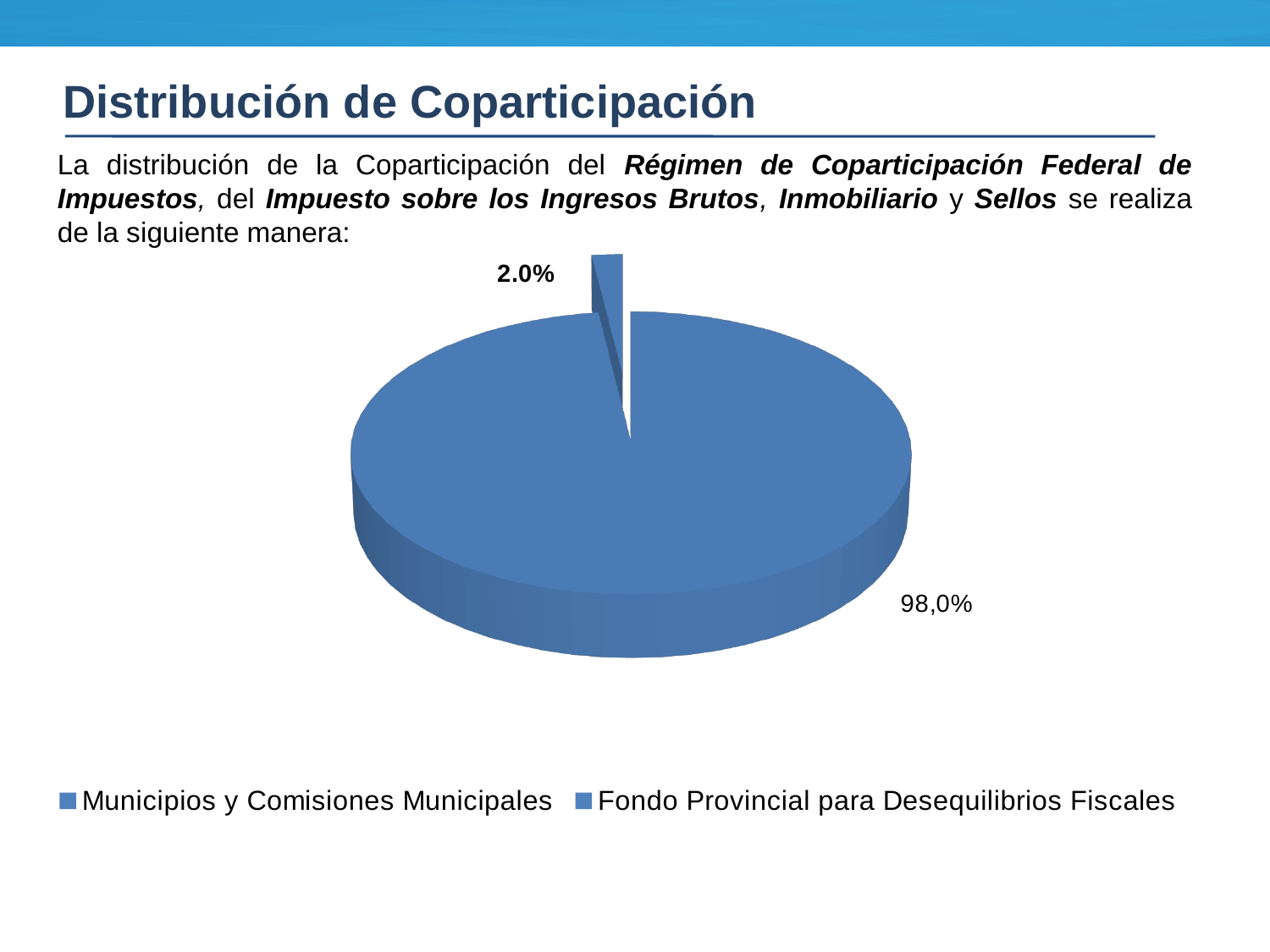
How many entries does the legend of the pie chart list? 2 What percentage is shown on the smallest slice of the pie chart? 2.0% What share of the pie does the small slice at the top represent? 2.0% What kind of chart is shown on the slide? Pie chart What is the title of the slide containing the pie chart? Distribución de Coparticipación What are the two entries listed in the legend of the pie chart? Municipios y Comisiones Municipales; Fondo Provincial para Desequilibrios Fiscales What percentage is shown on the largest slice of the pie chart? 98,0% How many slices does the pie chart have? 2 Which of the two labelled slices is larger, the one labelled 98,0% or the one labelled 2.0%? 98,0%